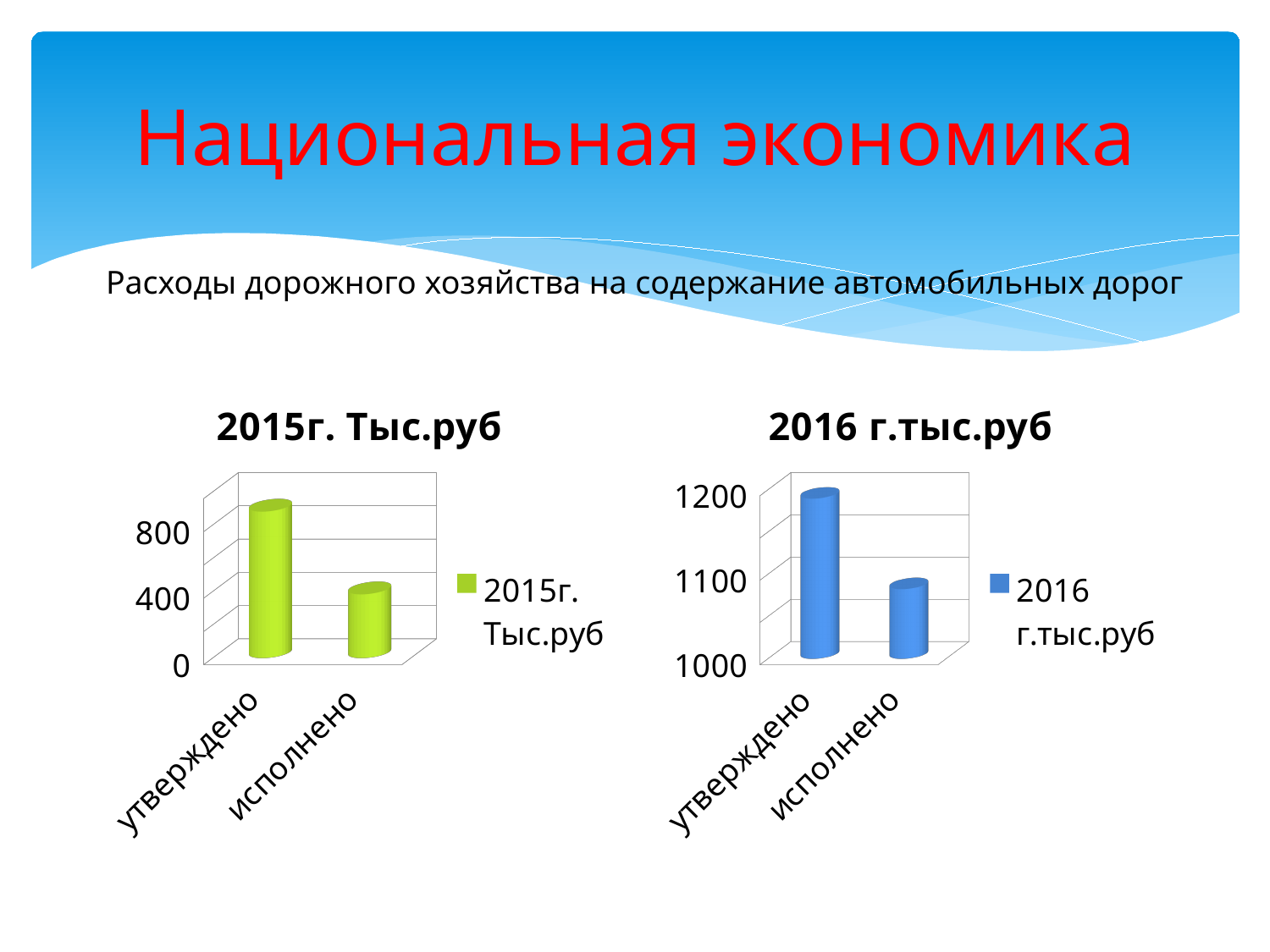
In the left chart "2015г. Тыс.руб", which category has the lowest value? исполнено In the right chart "2016 г.тыс.руб", which is larger: утверждено or исполнено? утверждено How many series does the legend of the right chart "2016 г.тыс.руб" list? 1 What colour are the bars in the right chart "2016 г.тыс.руб"? blue What kind of chart is the left chart titled "2015г. Тыс.руб"? bar chart In the right chart "2016 г.тыс.руб", is the value for исполнено greater or less than 1000? greater In the right chart "2016 г.тыс.руб", is the value for утверждено greater or less than 1100? greater In the left chart "2015г. Тыс.руб", is the value for утверждено greater or less than 800? greater In the left chart "2015г. Тыс.руб", which category has the highest value? утверждено How many categories are shown on the x axis of the left chart "2015г. Тыс.руб"? 2 In the right chart "2016 г.тыс.руб", which category has the highest value? утверждено What is the title of the left chart? 2015г. Тыс.руб